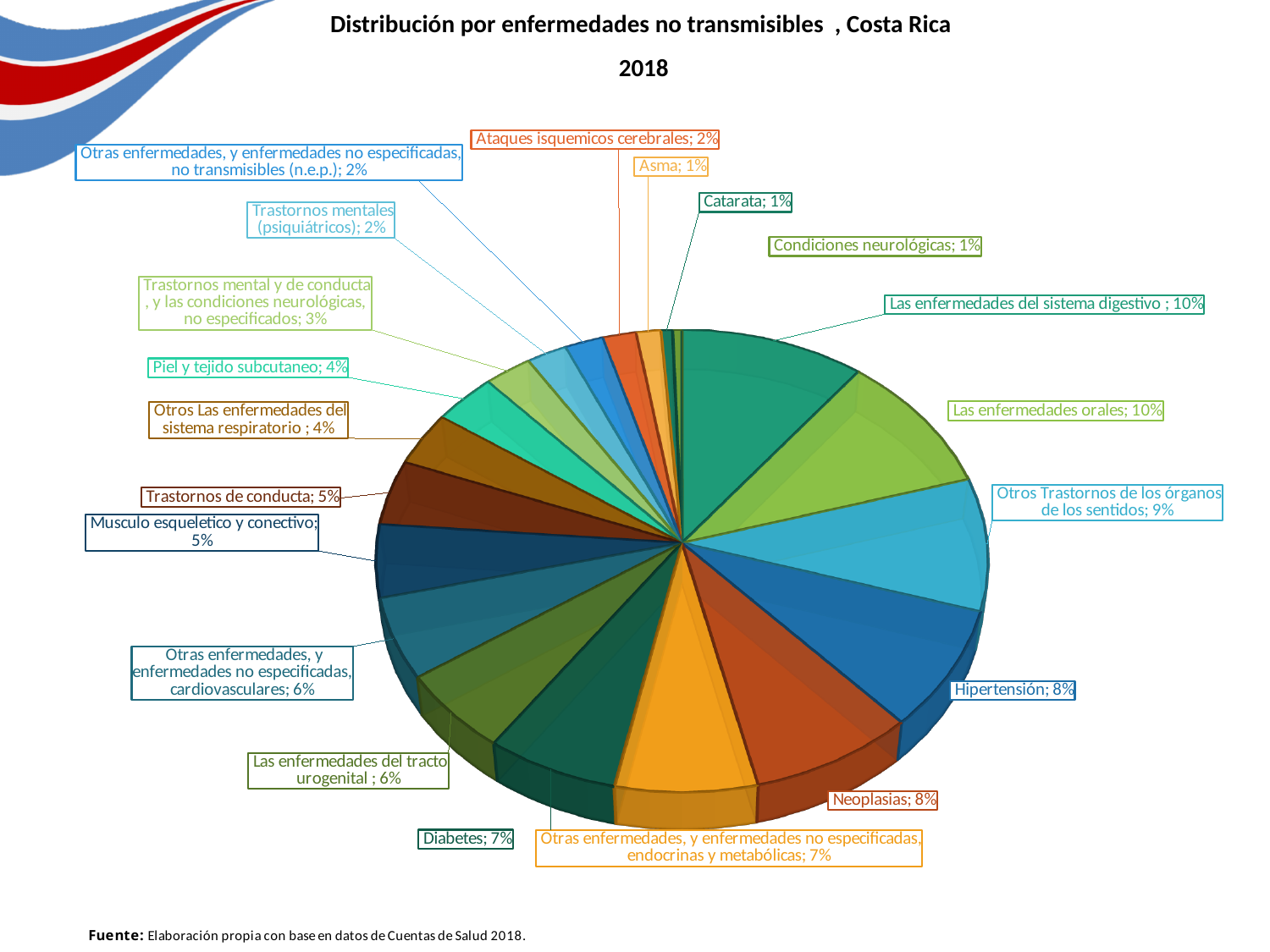
How many categories (slices) does the pie chart have? 20 What is the difference between Las enfermedades del sistema digestivo and Trastornos de conducta? 5% What is the value for Trastornos mentales (psiquiátricos)? 2% What percentage is shown for Piel y tejido subcutaneo? 4% Which is larger, Neoplasias or Las enfermedades del tracto urogenital? Neoplasias What year does the chart title refer to? 2018 What percentage is shown for Las enfermedades orales? 10% What share of the pie does Hipertensión represent? 8% What is the value for Otros Trastornos de los órganos de los sentidos? 9% What is the value for Asma? 1% What is the value shown for Diabetes? 7% What kind of chart is shown on the slide? pie chart